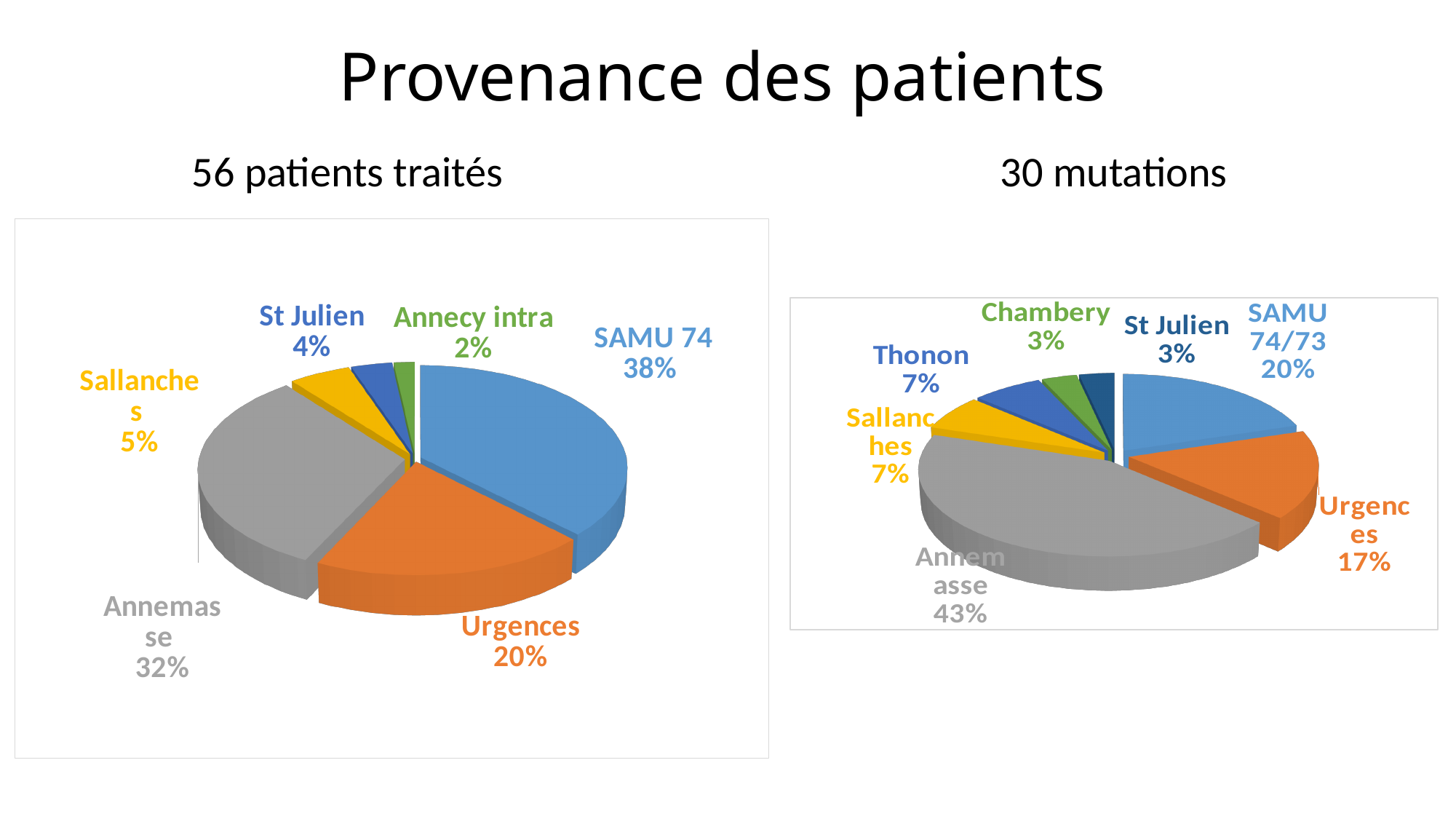
In the '56 patients traités' pie chart, which category has the largest share? SAMU 74 In the '30 mutations' pie chart, what share does Annemasse have? 43% In the '56 patients traités' pie chart, what share does Annemasse have? 32% In the '30 mutations' pie chart, how many categories are shown? 7 In the '30 mutations' pie chart, which is larger, the share of SAMU 74/73 or the share of Urgences? SAMU 74/73 In the '56 patients traités' pie chart, how many categories are shown? 6 In the '56 patients traités' pie chart, what is the difference between the shares of SAMU 74 and Urgences? 18% In the '56 patients traités' pie chart, what share does SAMU 74 have? 38% In the '30 mutations' pie chart, what share does Urgences have? 17% In the '30 mutations' pie chart, which category has the largest share? Annemasse In the '56 patients traités' pie chart, which category has the smallest share? Annecy intra What kind of chart is used on the left side of the slide? Pie chart